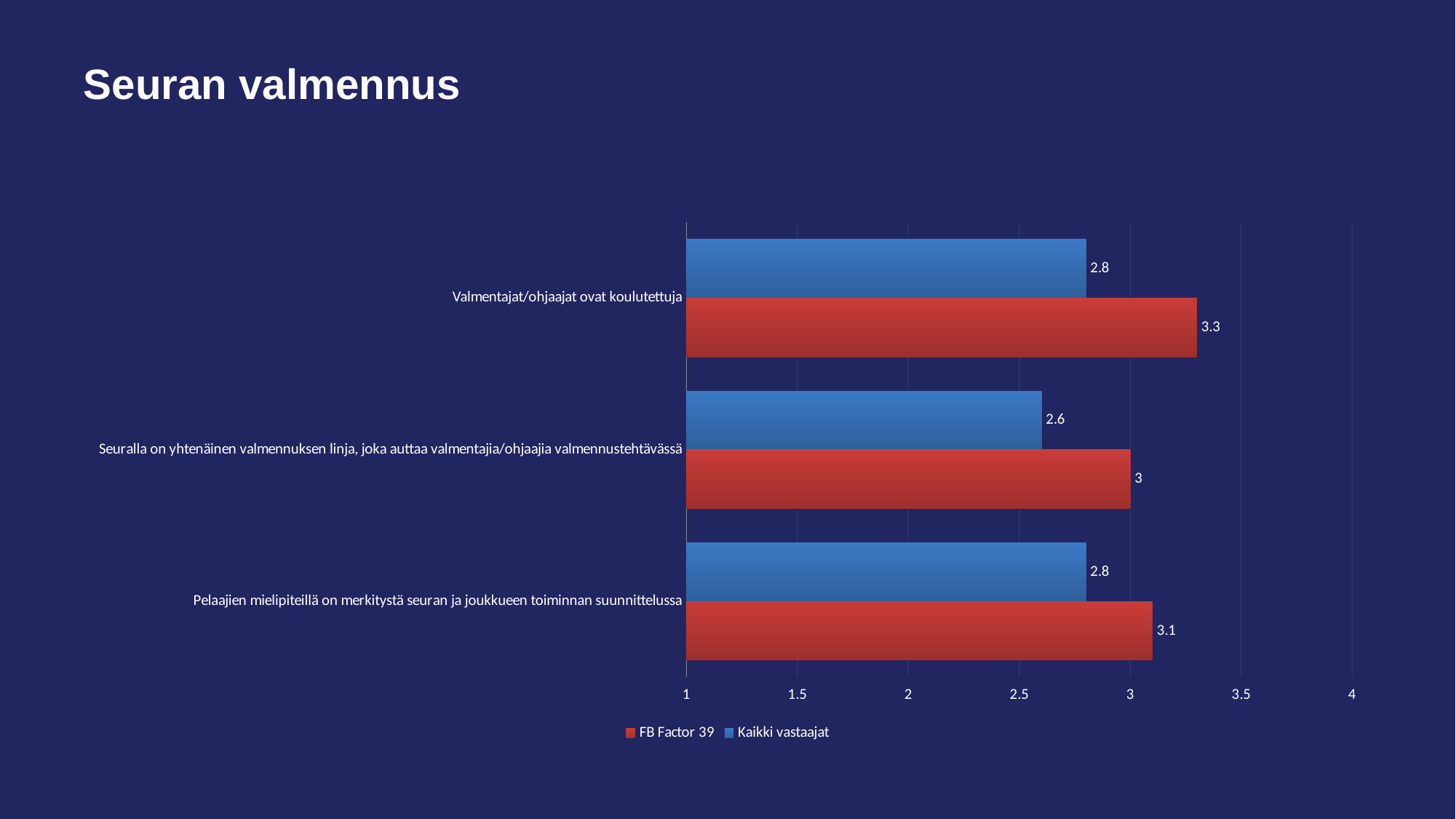
For "Seuralla on yhtenäinen valmennuksen linja, joka auttaa valmentajia/ohjaajia valmennustehtävässä", which series has the larger value, FB Factor 39 or Kaikki vastaajat? FB Factor 39 What is the FB Factor 39 value for "Valmentajat/ohjaajat ovat koulutettuja"? 3.3 What is the difference between the FB Factor 39 and Kaikki vastaajat values for "Valmentajat/ohjaajat ovat koulutettuja"? 0.5 What kind of chart is shown on the slide? Bar chart What is the title of the slide? Seuran valmennus How many categories are shown on the chart? 3 What is the Kaikki vastaajat value for "Seuralla on yhtenäinen valmennuksen linja, joka auttaa valmentajia/ohjaajia valmennustehtävässä"? 2.6 Is the FB Factor 39 value for "Pelaajien mielipiteillä on merkitystä seuran ja joukkueen toiminnan suunnittelussa" greater or less than 3? greater What is the FB Factor 39 value for "Pelaajien mielipiteillä on merkitystä seuran ja joukkueen toiminnan suunnittelussa"? 3.1 Which category has the lowest Kaikki vastaajat value? Seuralla on yhtenäinen valmennuksen linja, joka auttaa valmentajia/ohjaajia valmennustehtävässä How many series does the legend list? 2 Which category has the highest FB Factor 39 value? Valmentajat/ohjaajat ovat koulutettuja